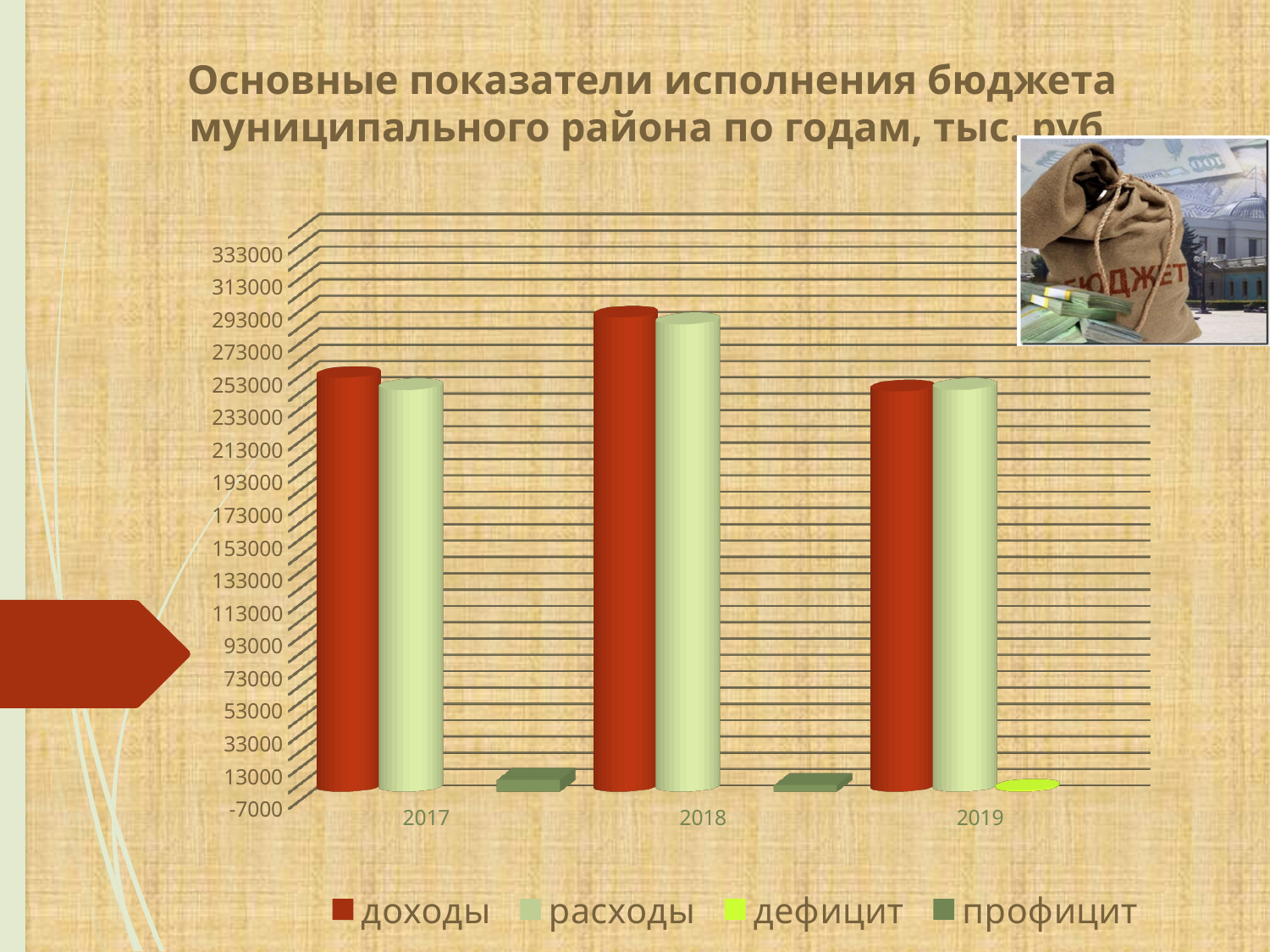
Is the value for расходы in 2017 greater or less than 273000? less In which year is the value for расходы the highest? 2018 In which year is the value for доходы the highest? 2018 In which year does the chart show a дефицит bar? 2019 Which series is shown in red in the chart legend? доходы What kind of chart is shown on the slide? bar chart Is the value for доходы in 2018 greater or less than 273000? greater How many series does the chart legend list? 4 Did the value for доходы rise or fall from 2017 to 2018? rise Is the value for доходы in 2017 greater or less than 213000? greater In 2017, which is larger: доходы or расходы? доходы How many years are shown on the x axis of the chart? 3